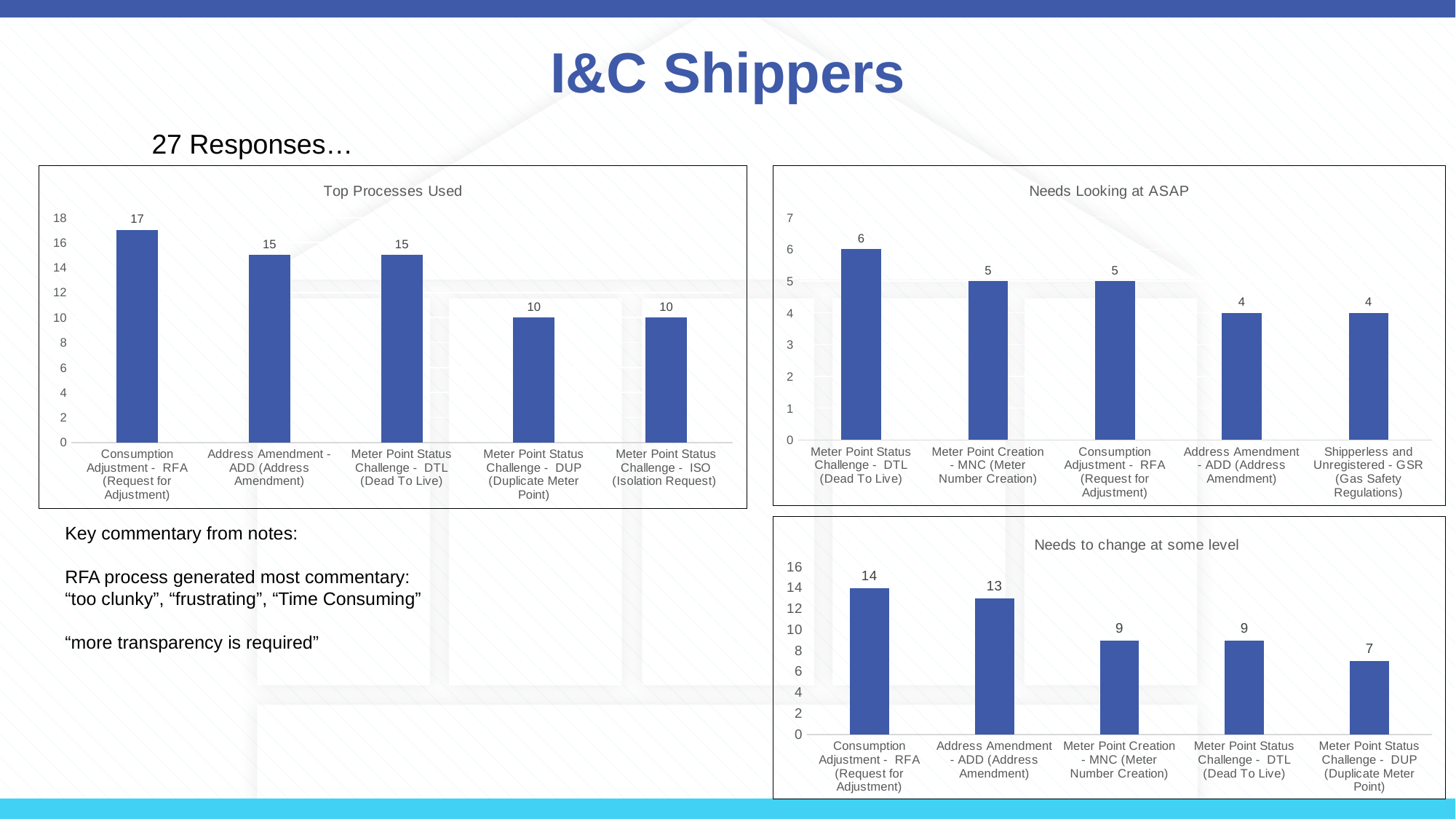
In the 'Top Processes Used' chart, what is the value for Consumption Adjustment - RFA (Request for Adjustment)? 17 In the 'Needs Looking at ASAP' chart, what is the value for Shipperless and Unregistered - GSR (Gas Safety Regulations)? 4 In the 'Needs to change at some level' chart, which is larger: Consumption Adjustment - RFA or Meter Point Creation - MNC? Consumption Adjustment - RFA In the 'Needs to change at some level' chart, do the values rise or fall from left to right? fall In the 'Needs Looking at ASAP' chart, which category has the highest value? Meter Point Status Challenge - DTL (Dead To Live) In the 'Needs to change at some level' chart, what is the value for Address Amendment - ADD (Address Amendment)? 13 In the 'Top Processes Used' chart, which category has the highest value? Consumption Adjustment - RFA (Request for Adjustment) In the 'Top Processes Used' chart, what is the difference between Consumption Adjustment - RFA and Meter Point Status Challenge - DUP? 7 In the 'Top Processes Used' chart, how many categories are plotted? 5 What kind of chart is 'Top Processes Used'? bar chart In the 'Needs Looking at ASAP' chart, what is the value for Meter Point Status Challenge - DTL (Dead To Live)? 6 In the 'Needs to change at some level' chart, which category has the lowest value? Meter Point Status Challenge - DUP (Duplicate Meter Point)